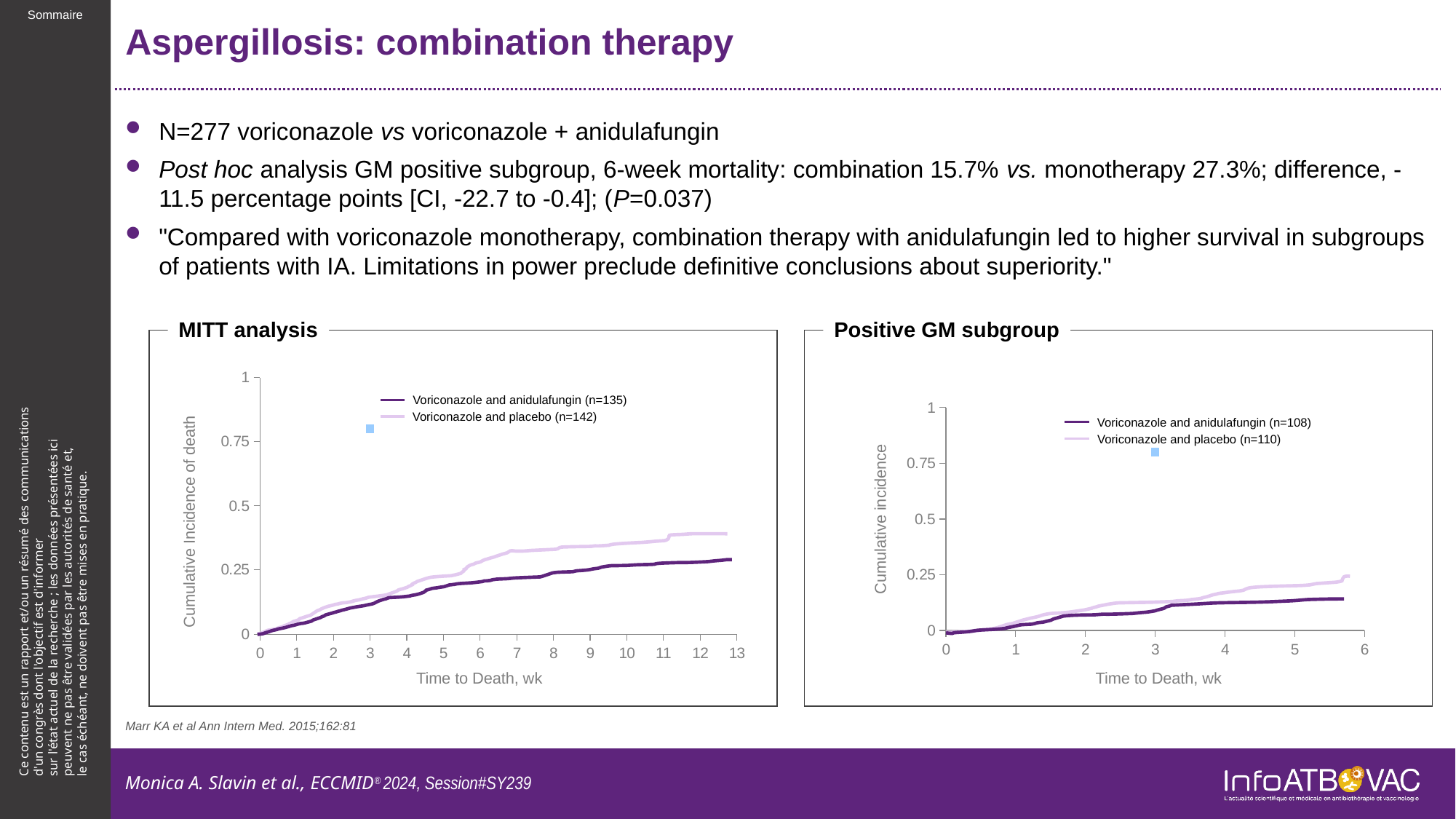
In the MITT analysis chart, do the cumulative incidence curves rise or fall as time to death increases? rise What kind of chart is the MITT analysis chart? line chart In the Positive GM subgroup chart, which series has the higher cumulative incidence at week 5: voriconazole and anidulafungin or voriconazole and placebo? Voriconazole and placebo What is the x-axis label of the Positive GM subgroup chart? Time to Death, wk In the MITT analysis chart, which series has the higher cumulative incidence of death at week 13: voriconazole and anidulafungin or voriconazole and placebo? Voriconazole and placebo How many series does the legend of the MITT analysis chart list? 2 What is the highest tick value shown on the y-axis of the Positive GM subgroup chart? 1 How many series does the legend of the Positive GM subgroup chart list? 2 In the MITT analysis chart, is the cumulative incidence of death for voriconazole and placebo at week 13 greater or less than 0.5? less In the MITT analysis chart, is the cumulative incidence of death for voriconazole and placebo at week 13 greater or less than 0.25? greater According to the legend of the MITT analysis chart, how many patients were in the voriconazole and placebo group? n=142 In the Positive GM subgroup chart, is the cumulative incidence for voriconazole and anidulafungin at week 5 greater or less than 0.25? less